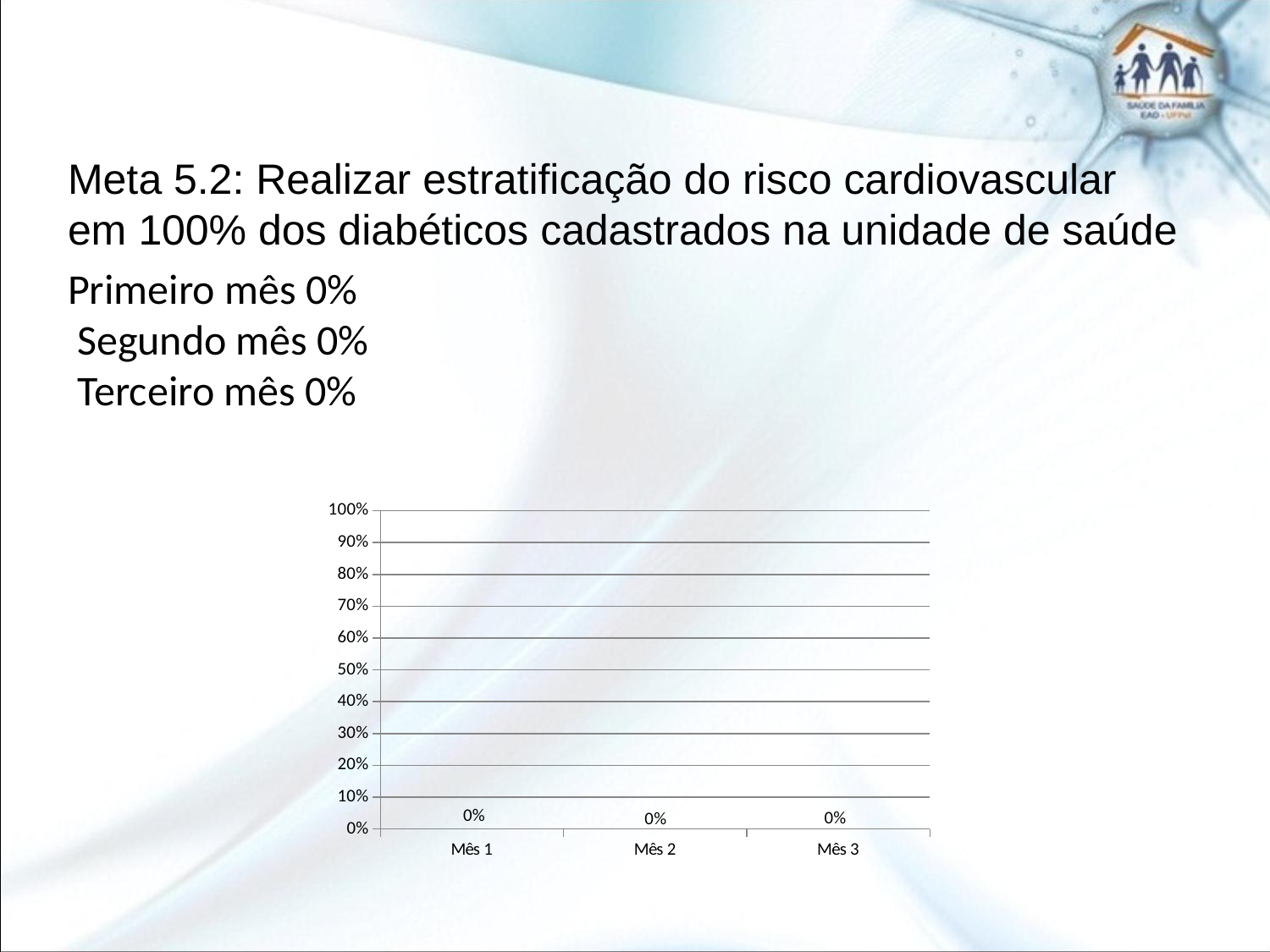
What is the label of the first category on the x axis? Mês 1 What is the value for Mês 1? 0% What is the difference between the values for Mês 1 and Mês 3? 0% What is the highest value shown on the chart's vertical axis? 100% What is the value for Mês 2? 0% Do the values rise, fall, or stay the same from Mês 1 to Mês 3? stay the same Is the value for Mês 2 greater or less than 50%? less How many categories are shown on the x axis of the chart? 3 What is the value for Mês 3? 0% What is the difference between the values for Mês 2 and Mês 3? 0%